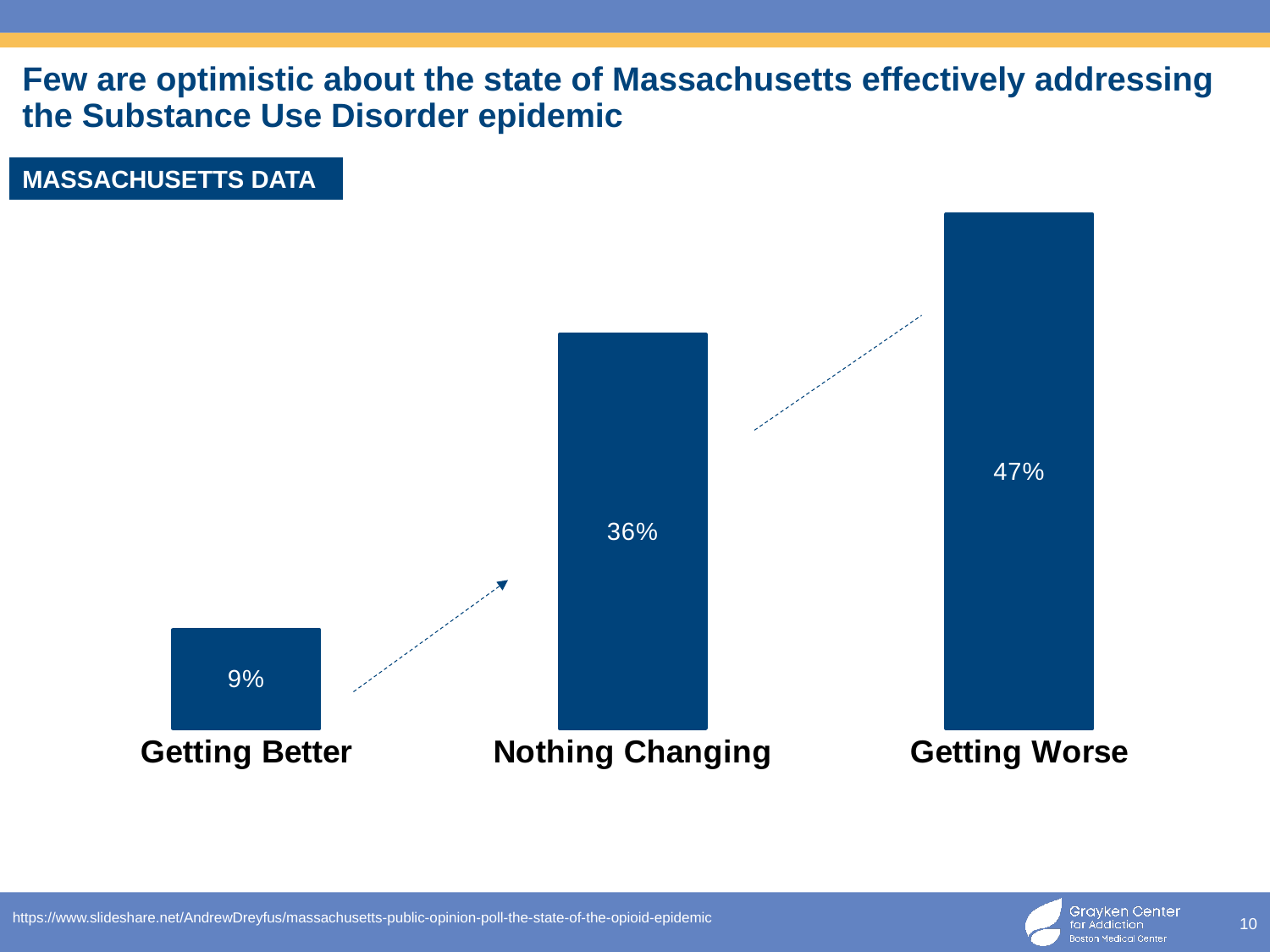
Do the values rise or fall from Getting Better to Getting Worse? Rise Which category has the highest value? Getting Worse What percentage is shown for Nothing Changing? 36% Which category has the lowest value? Getting Better How many categories are shown in the chart? 3 Which is larger, the value for Getting Better or the value for Nothing Changing? Nothing Changing What kind of chart is shown on the slide? Bar chart What label appears in the box above the chart? MASSACHUSETTS DATA What percentage is shown for Getting Worse? 47% What is the difference between the values for Getting Worse and Nothing Changing? 11% What is the difference between the values for Nothing Changing and Getting Better? 27% What percentage is shown for Getting Better? 9%